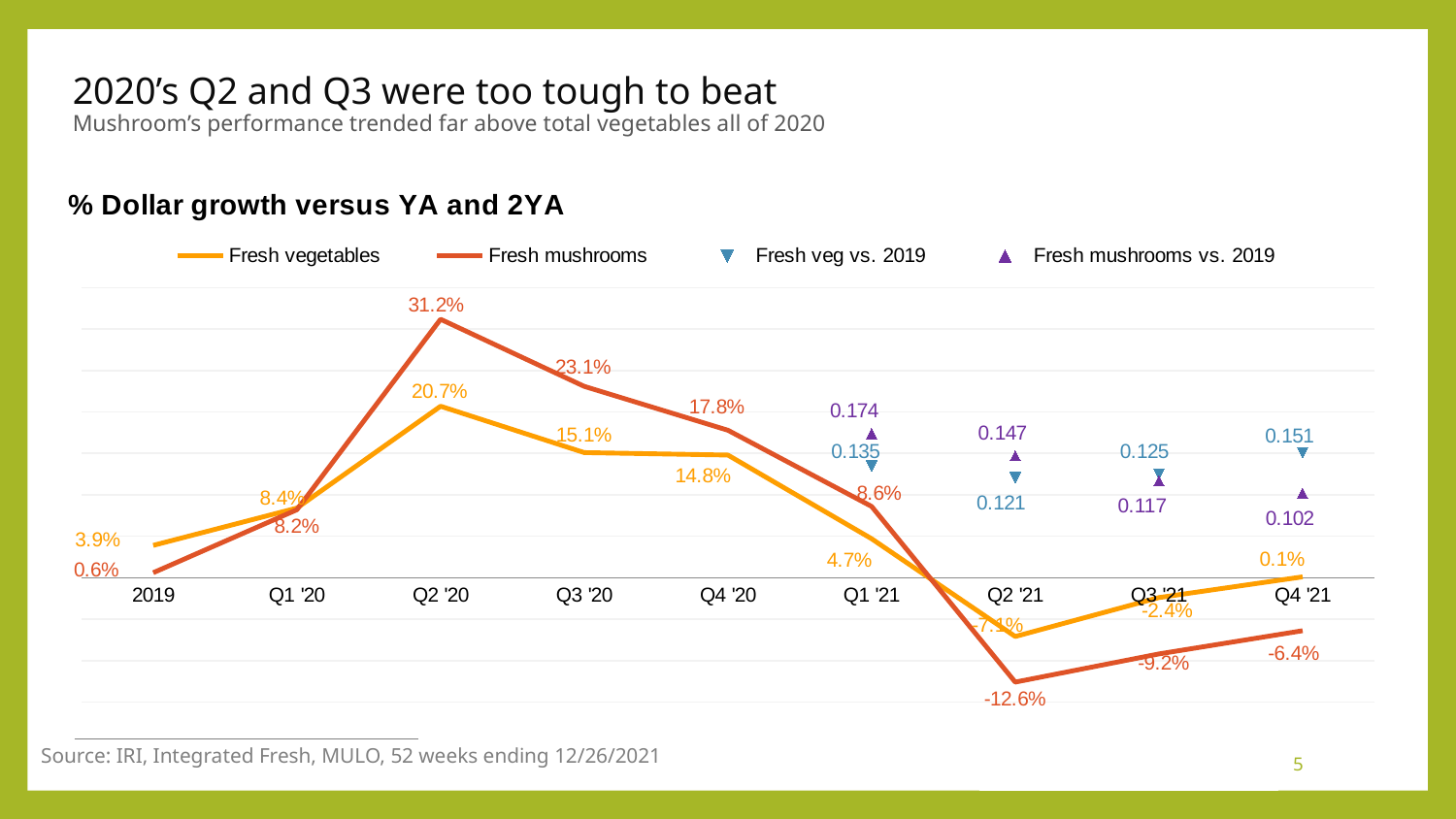
Does the Fresh mushrooms line rise or fall from Q2 '20 to Q2 '21? Fall In which period does the Fresh mushrooms line reach its highest value? Q2 '20 In which period does the Fresh mushrooms line reach its lowest value? Q2 '21 In Q1 '21, which is larger: the Fresh mushrooms value or the Fresh vegetables value? Fresh mushrooms What is the Fresh mushrooms vs. 2019 value in Q1 '21? 0.174 How many periods are shown on the x axis? 9 What is the Fresh veg vs. 2019 value in Q4 '21? 0.151 What is the value for Fresh vegetables in Q4 '20? 14.8% What kind of chart is this? Line chart How many series does the legend list? 4 In Q2 '20, how much higher is the Fresh mushrooms value than the Fresh vegetables value? 10.5 percentage points What is the value for Fresh mushrooms in Q2 '20? 31.2%